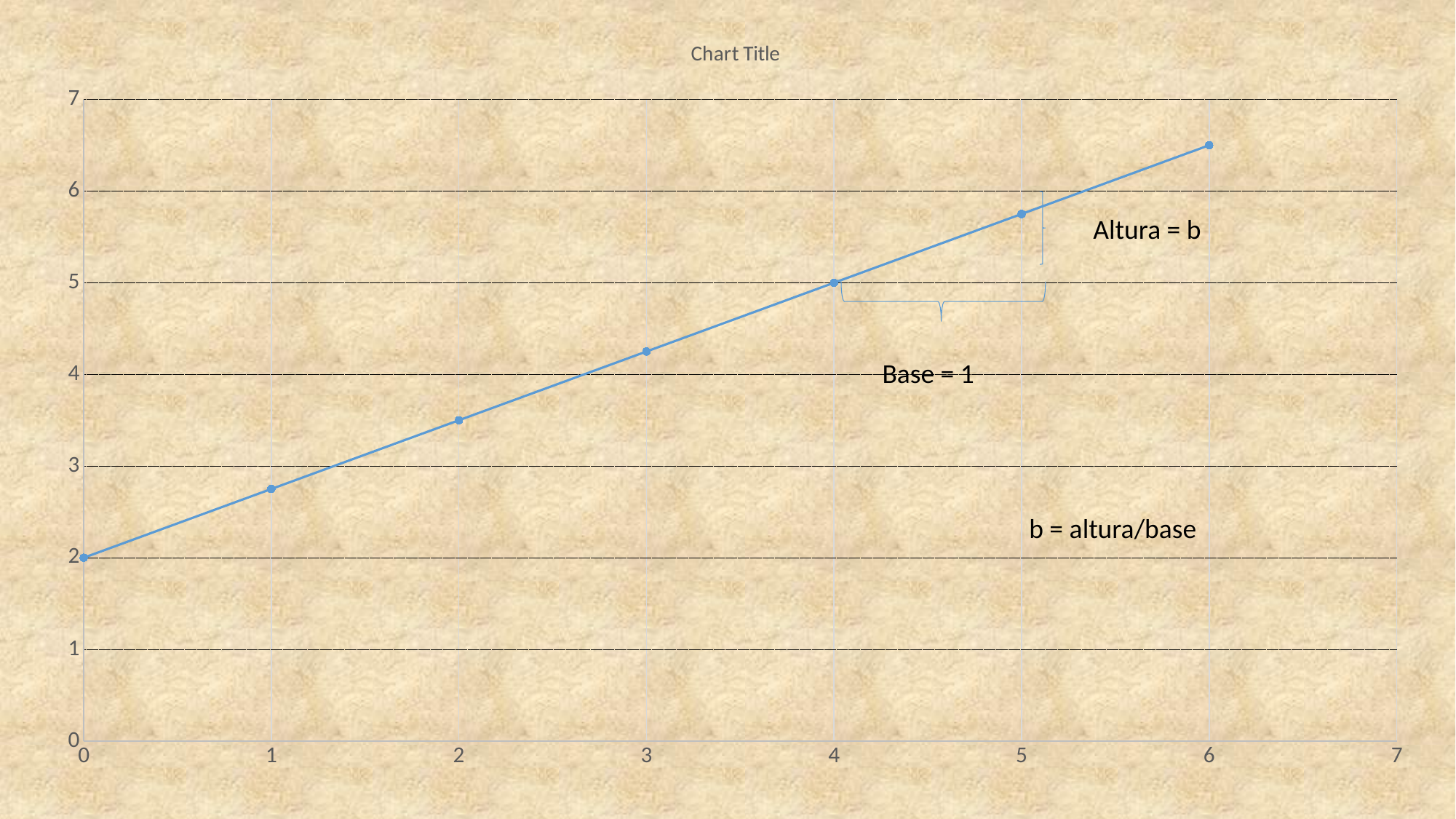
What is the y value of the point at x = 0? 2 What is the title shown above the chart? Chart Title At which x value is the plotted y value highest? 6 What is the y value of the point at x = 4? 5 Do the plotted values rise or fall as x increases from 0 to 6? rise Is the y value at x = 5 greater or less than 5? greater Is the y value at x = 3 greater or less than 4? greater What kind of chart is shown on the slide? line chart At which x value is the plotted y value lowest? 0 Is the y value at x = 6 greater or less than 6? greater How many data points are plotted on the line? 7